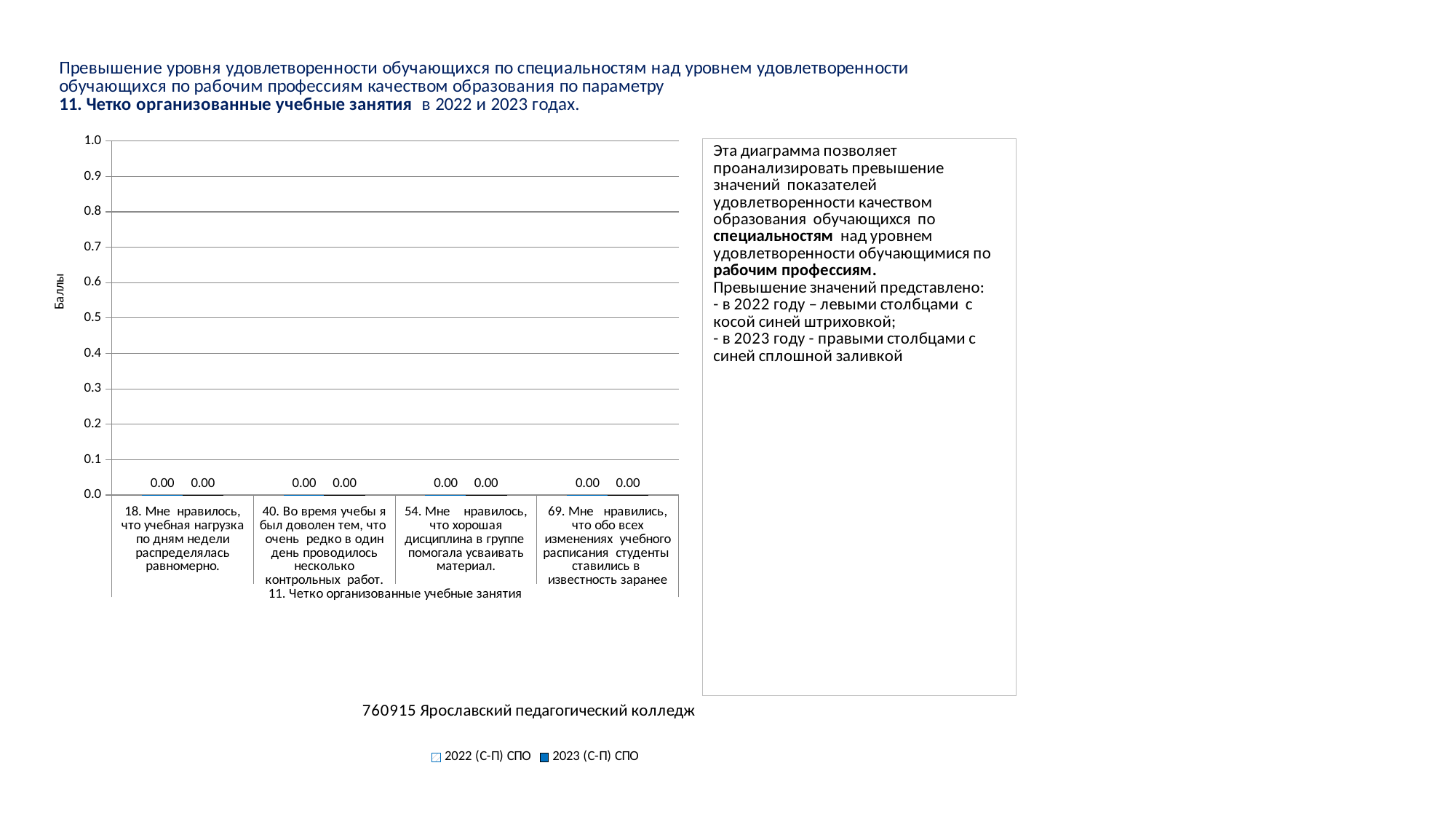
What is the label of the vertical axis of the chart? Баллы How many series does the chart legend list? 2 Do the values rise, fall, or stay the same across the categories along the x axis? stay the same What is the title shown below the chart? 760915 Ярославский педагогический колледж What is the value for 2023 (С-П) СПО for category 69 (Мне нравились, что обо всех изменениях учебного расписания студенты ставились в известность заранее)? 0.00 How many categories are shown on the x axis of the chart? 4 What kind of chart is shown on the slide? bar chart What is the difference between the 2022 (С-П) СПО and 2023 (С-П) СПО values for category 18? 0.00 What is the value for 2022 (С-П) СПО for category 54 (Мне нравилось, что хорошая дисциплина в группе помогала усваивать материал)? 0.00 Is the value for 2023 (С-П) СПО for category 54 greater or less than 0.1? less What is the value for 2022 (С-П) СПО for category 18 (Мне нравилось, что учебная нагрузка по дням недели распределялась равномерно)? 0.00 What is the value for 2023 (С-П) СПО for category 40 (Во время учебы я был доволен тем, что очень редко в один день проводилось несколько контрольных работ)? 0.00